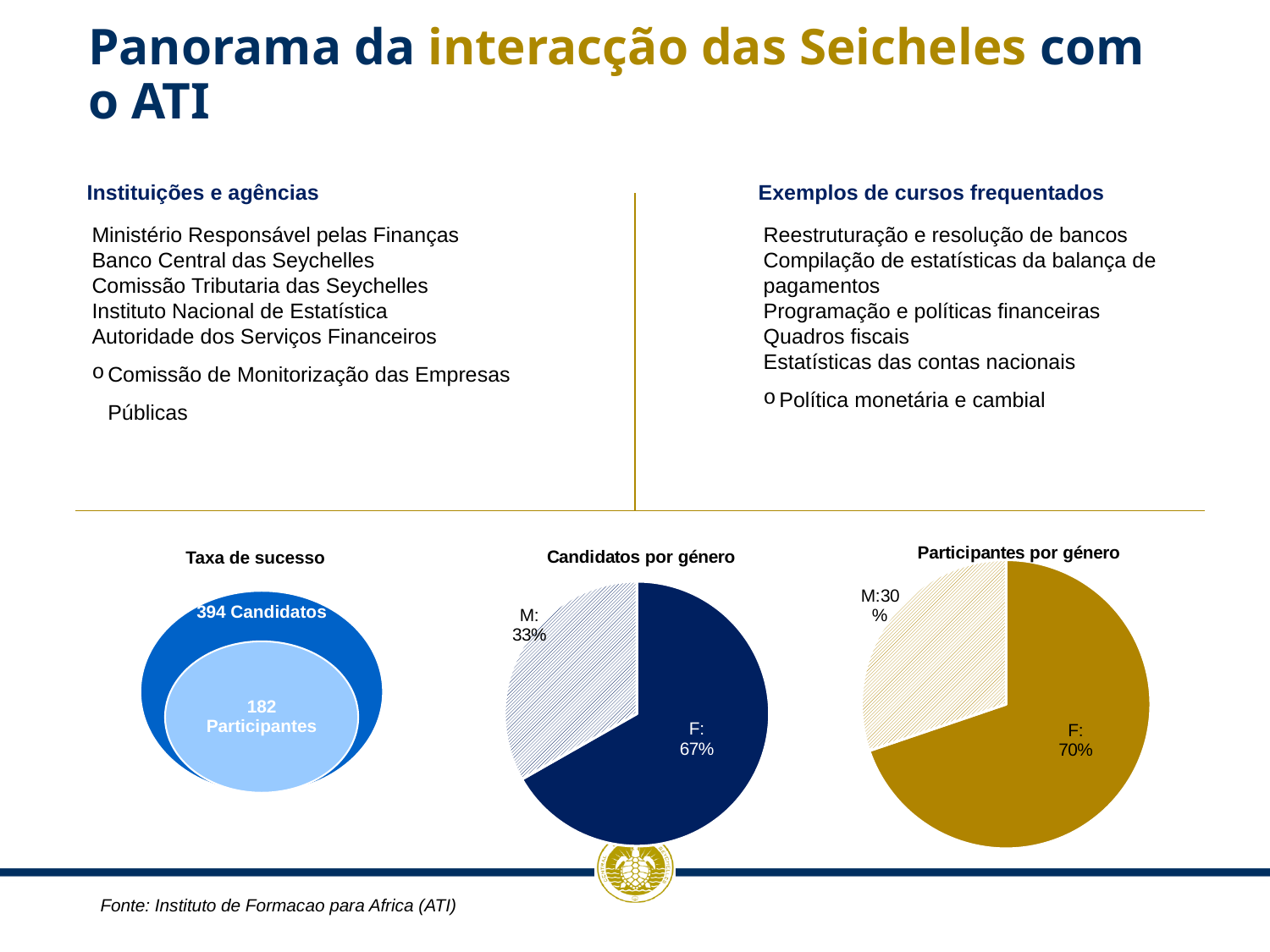
Is the F share larger in the 'Candidatos por género' chart or in the 'Participantes por género' chart? Participantes por género What kind of chart is 'Candidatos por género'? Pie chart In the 'Participantes por género' chart, which slice is the smallest? M How many slices does the 'Participantes por género' chart have? 2 In the 'Participantes por género' chart, what is the difference in percentage points between the F and M slices? 40 In the 'Candidatos por género' chart, what share is labelled F? 67% In the 'Participantes por género' chart, what share is labelled F? 70% In the 'Candidatos por género' chart, what share is labelled M? 33% In the 'Candidatos por género' chart, what is the difference in percentage points between the F and M slices? 34 In the 'Candidatos por género' chart, which slice is the largest? F In the 'Participantes por género' chart, what share is labelled M? 30% In the 'Taxa de sucesso' diagram, how many Candidatos are shown in the outer circle? 394